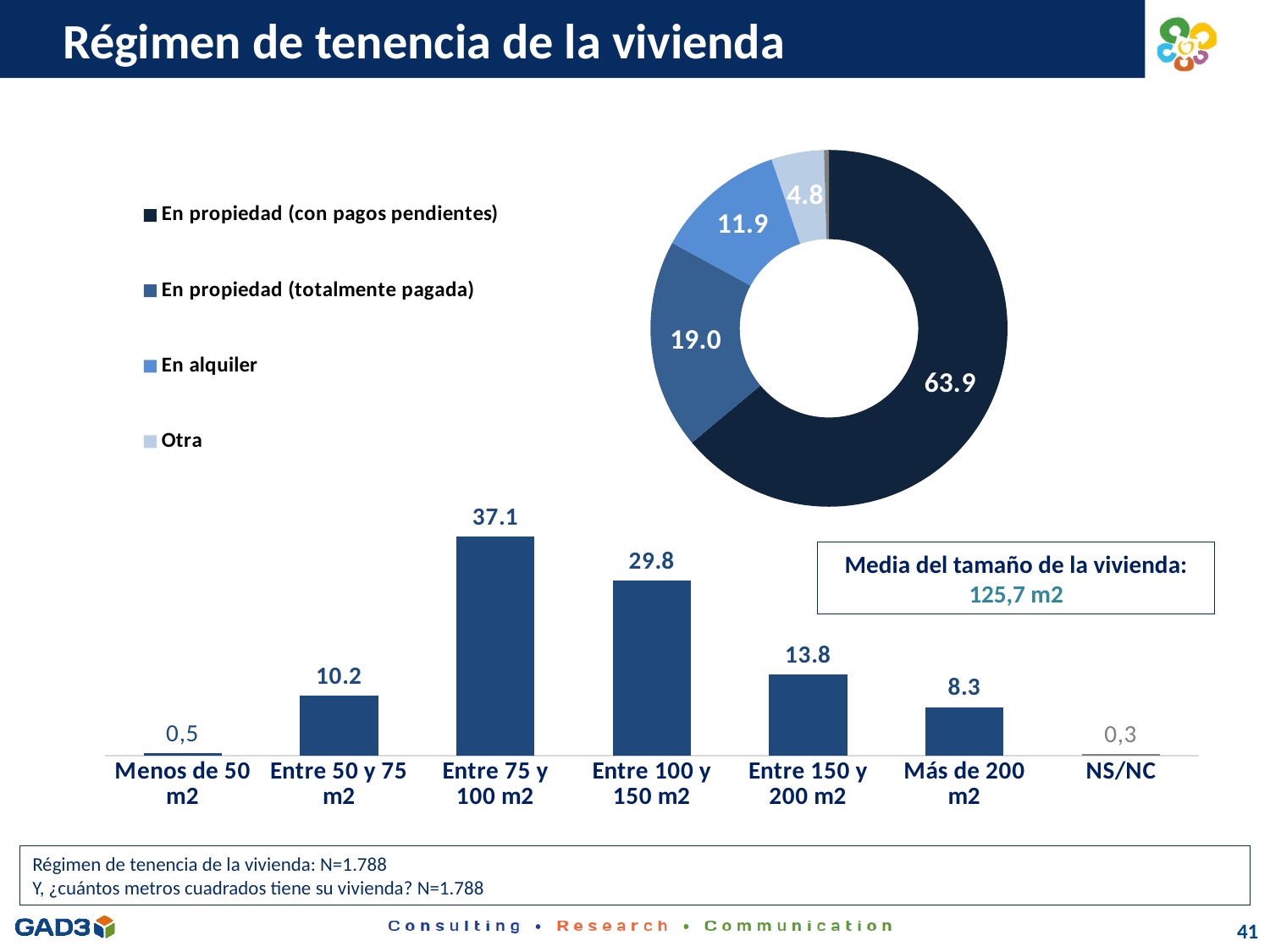
In the donut chart at the top, what is the value for 'En propiedad (con pagos pendientes)'? 63.9 How many entries does the legend of the donut chart at the top list? 4 How many categories are shown in the bar chart at the bottom? 7 In the bar chart at the bottom, what is the difference between 'Entre 75 y 100 m2' and 'Entre 100 y 150 m2'? 7.3 In the bar chart at the bottom, what is the value for 'Entre 75 y 100 m2'? 37.1 In the bar chart at the bottom, which category has the lowest value? NS/NC In the donut chart at the top, what is the value for 'En alquiler'? 11.9 In the donut chart at the top, what is the difference between 'En propiedad (totalmente pagada)' and 'Otra'? 14.2 In the bar chart at the bottom, which is larger: 'Entre 100 y 150 m2' or 'Entre 150 y 200 m2'? Entre 100 y 150 m2 In the donut chart at the top, which category has the largest share? En propiedad (con pagos pendientes) What type of chart is the chart at the bottom of the slide? Bar chart In the bar chart at the bottom, what is the value for 'Más de 200 m2'? 8.3